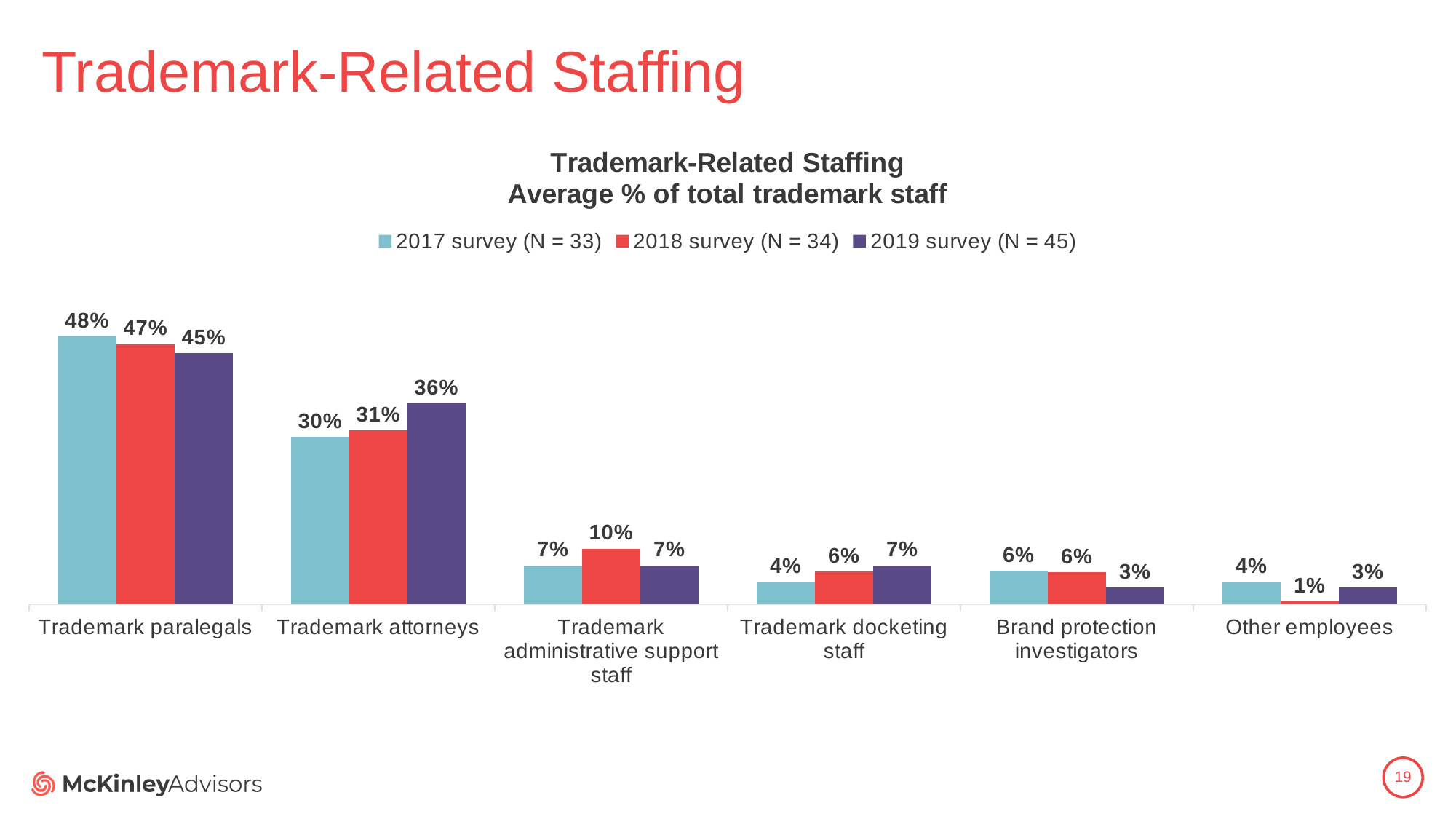
Which is larger for Brand protection investigators: the 2017 survey value or the 2019 survey value? 2017 survey What is the difference between the 2017 survey and 2019 survey values for Trademark attorneys? 6% What is the value for Other employees in the 2018 survey? 1% Which category has the lowest value in the 2018 survey? Other employees How many series does the legend list? 3 What is the value for Trademark administrative support staff in the 2018 survey? 10% What is the value for Trademark attorneys in the 2019 survey? 36% What kind of chart is shown on the slide? Bar chart How many staffing categories are shown on the x axis? 6 Which category has the highest value in the 2019 survey? Trademark paralegals What is the value for Trademark paralegals in the 2017 survey? 48% Did the value for Trademark docketing staff rise or fall from the 2017 survey to the 2019 survey? Rise